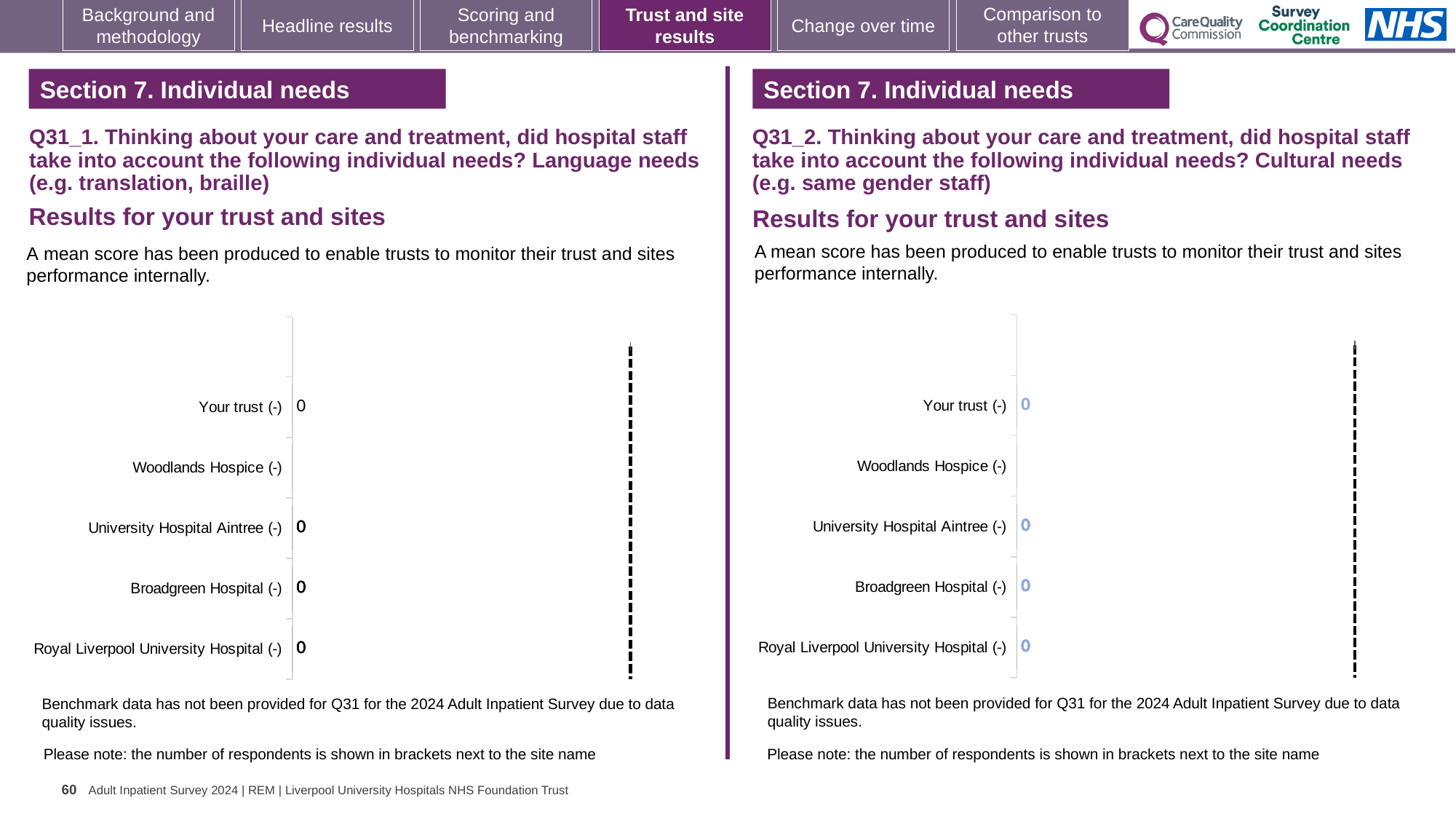
In the left chart (Q31_1, Language needs), what is the difference between the values for Your trust and Broadgreen Hospital? 0 How many categories (sites including Your trust) are listed on the right chart (Q31_2, Cultural needs)? 5 What kind of chart is the left chart (Q31_1, Language needs)? Bar chart How many categories (sites including Your trust) are listed on the left chart (Q31_1, Language needs)? 5 In the right chart (Q31_2, Cultural needs), what is the value shown for Your trust? 0 Which site on the left chart (Q31_1, Language needs) has no value label printed next to it? Woodlands Hospice (-) Which section heading appears above both charts on the slide? Section 7. Individual needs In the left chart (Q31_1, Language needs), what is the value shown for Royal Liverpool University Hospital? 0 In the right chart (Q31_2, Cultural needs), what is the value shown for University Hospital Aintree? 0 In the left chart (Q31_1, Language needs), what is the value shown for Your trust? 0 In the left chart (Q31_1, Language needs), what is the value shown for Broadgreen Hospital? 0 In the right chart (Q31_2, Cultural needs), what is the value shown for Broadgreen Hospital? 0